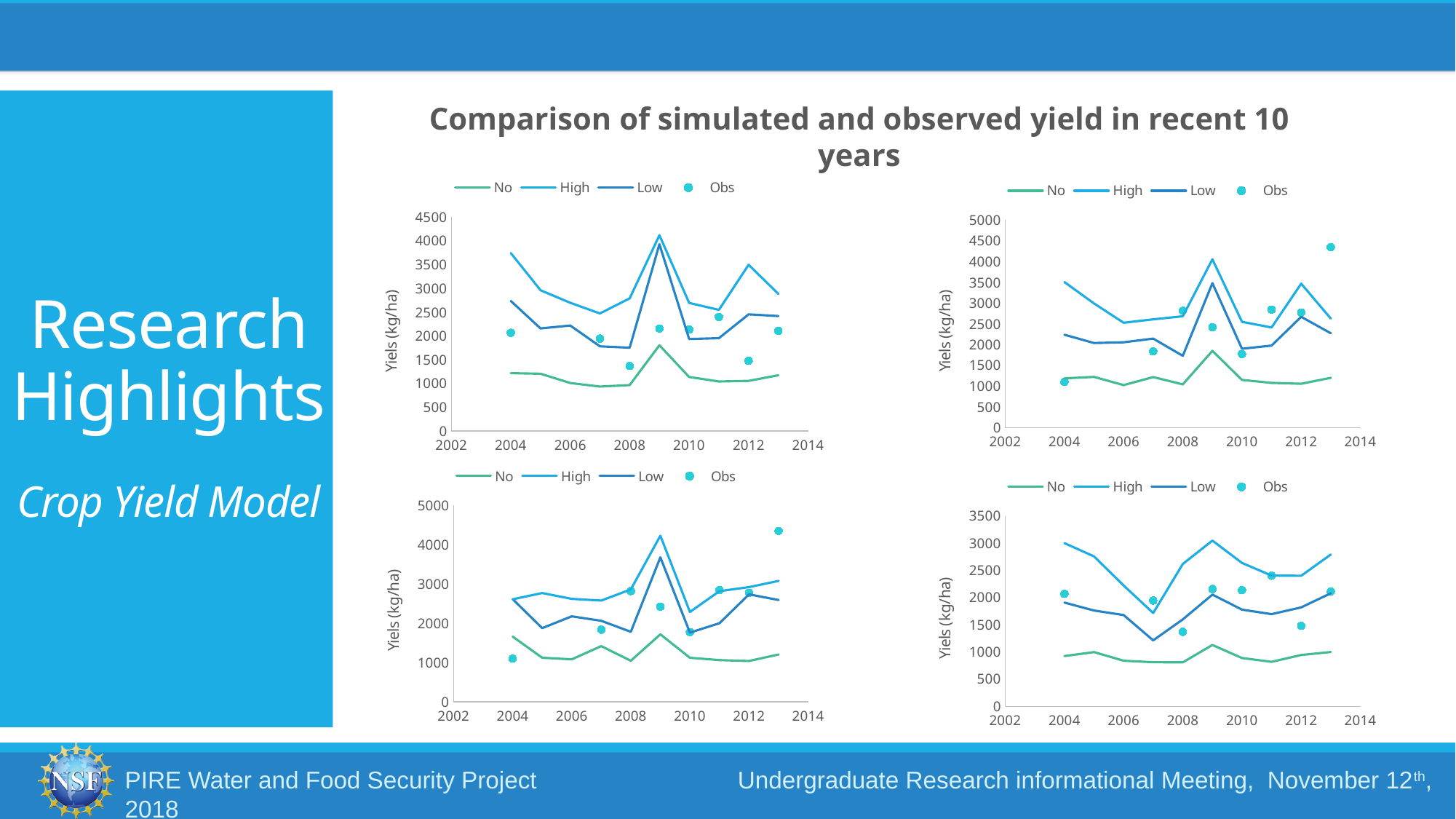
In the top-left chart, is the High value for 2009 greater or less than 3500? greater How many Obs points are plotted in the bottom-right chart? 8 In the bottom-right chart, is the No value for 2004 greater or less than 1500? less In the top-right chart, is the Obs value for 2013 greater or less than 4000? greater In the top-left chart, which is larger at 2009, the High series or the No series? High What kind of chart is the top-left chart? line chart In the bottom-right chart, which series has the lowest values across all years? No In the top-left chart, does the High series rise or fall from 2004 to 2007? fall In the top-left chart, in which year does the High series reach its peak? 2009 What is the overall title above the four charts? Comparison of simulated and observed yield in recent 10 years How many series does the legend of the top-left chart list? 4